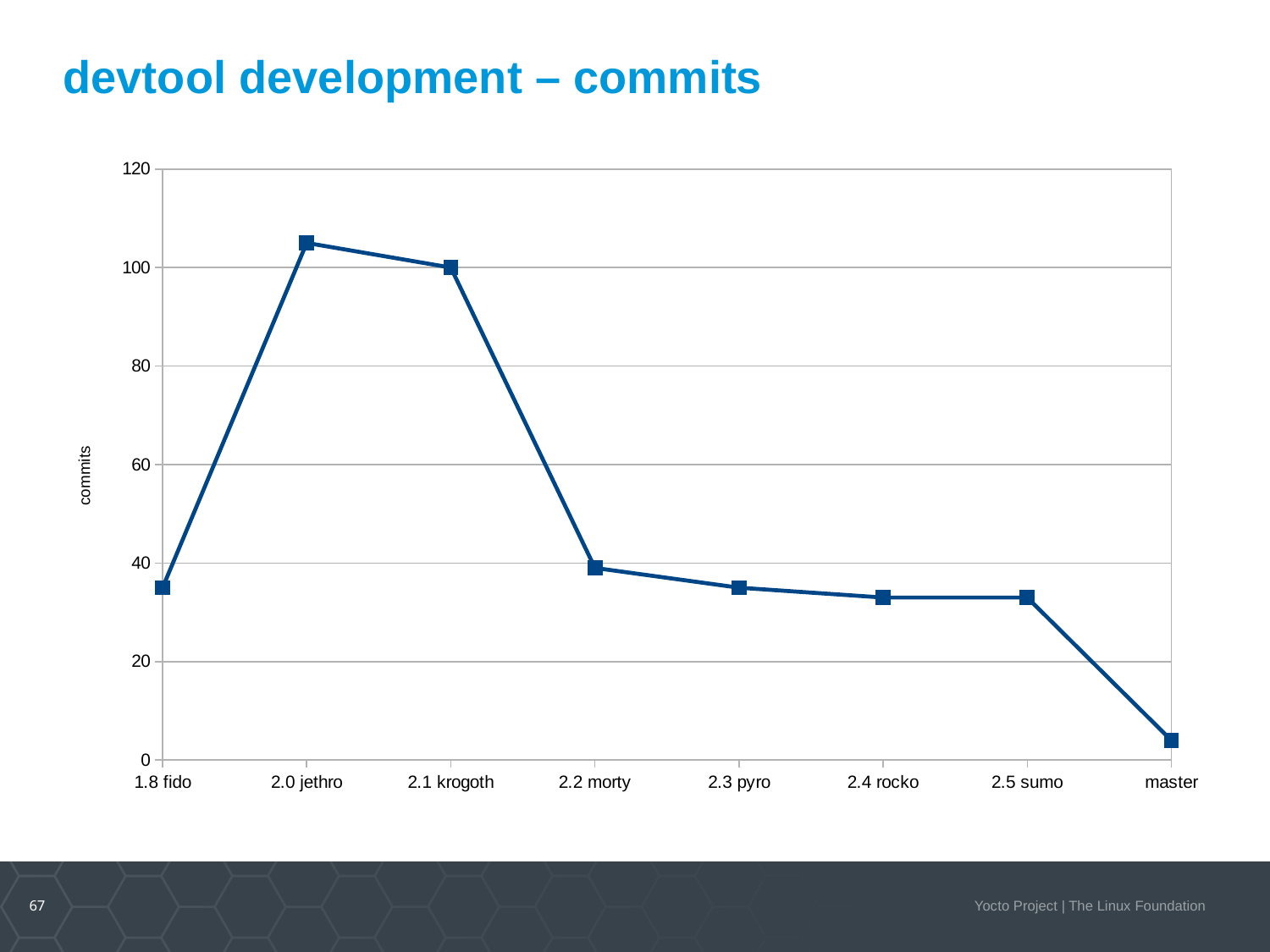
Is the value for 1.8 fido greater or less than 40? less How many release points are plotted on the chart? 8 Which release has the lowest number of commits? master Which release has the highest number of commits? 2.0 jethro Is the value for 2.4 rocko greater or less than 40? less Which has more commits, 1.8 fido or 2.0 jethro? 2.0 jethro Do the commit values rise or fall from 2.1 krogoth to master? fall How many commits are shown for 2.1 krogoth? 100 What kind of chart is shown on the slide? line chart Is the value for master greater or less than 20? less What is the label on the vertical axis? commits